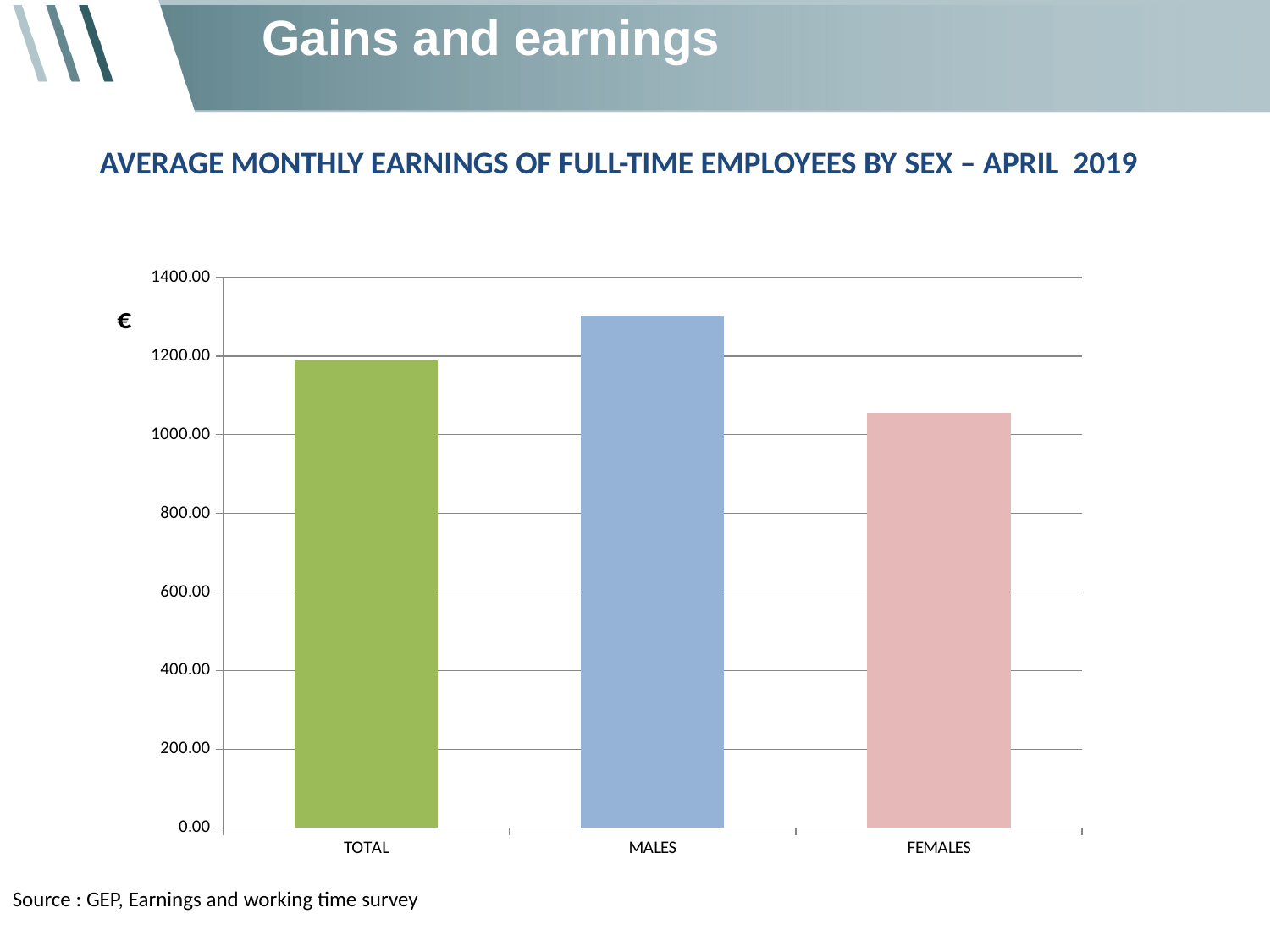
What is the title of the chart? AVERAGE MONTHLY EARNINGS OF FULL-TIME EMPLOYEES BY SEX – APRIL 2019 Which category has the lowest average monthly earnings? FEMALES Which is larger, the value for TOTAL or the value for FEMALES? TOTAL What currency symbol is shown on the vertical axis? € What type of chart is shown on the slide? bar chart Is the value for FEMALES greater or less than 1000.00? greater Is the value for FEMALES greater or less than 1200.00? less Which is larger, the value for MALES or the value for FEMALES? MALES How many categories are plotted in the chart? 3 Which category has the highest average monthly earnings? MALES Is the value for TOTAL greater or less than 1000.00? greater